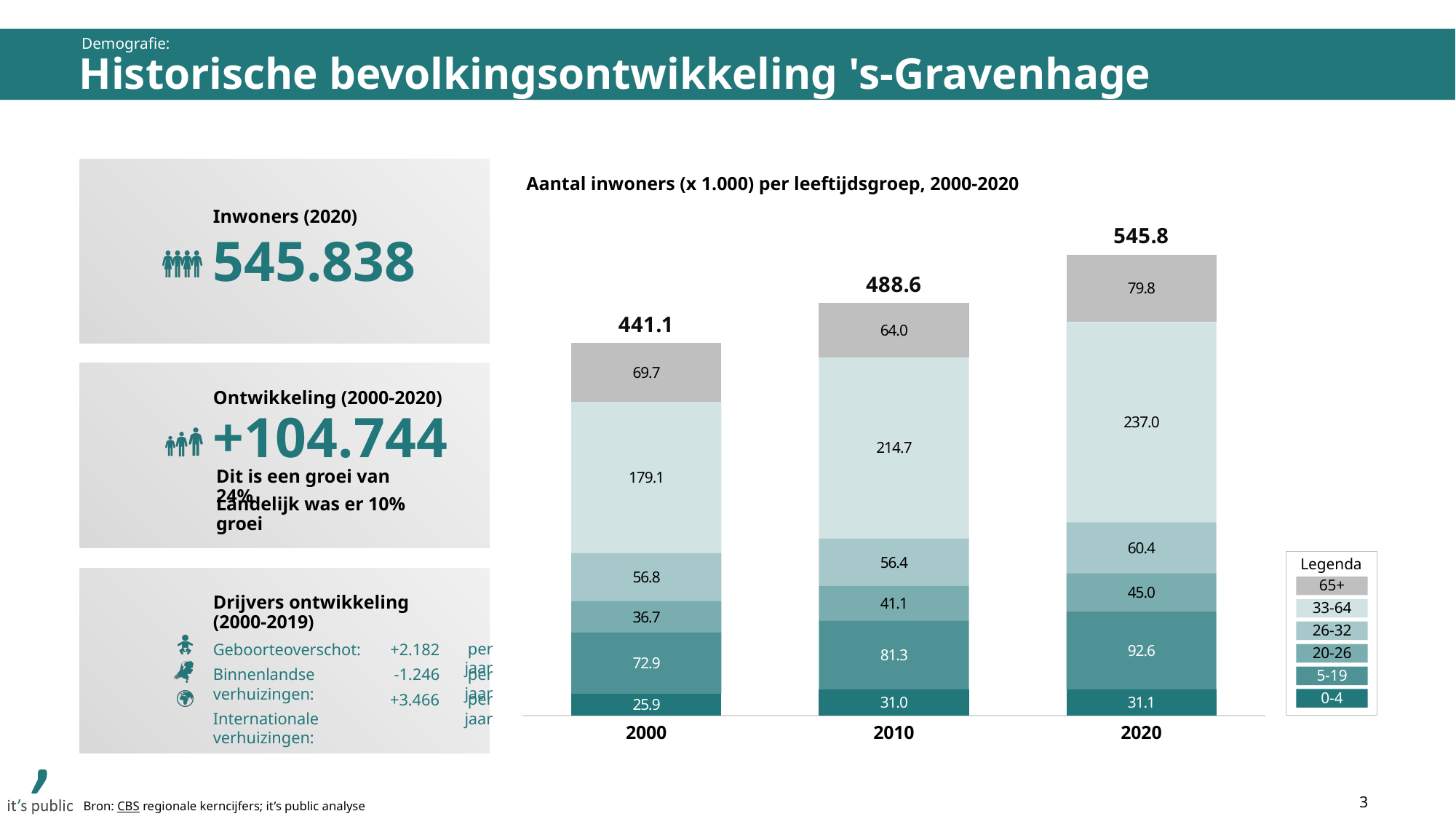
Which is larger: the 65+ value in 2000 or in 2010? 2000 What is the total number of inhabitants (x 1.000) shown for 2020? 545.8 What is the difference between the 33-64 values for 2020 and 2000? 57.9 Which year has the highest total number of inhabitants? 2020 What is the value for the 5-19 age group in 2020? 92.6 Which year has the lowest value for the 0-4 age group? 2000 What is the value for the 65+ age group in 2000? 69.7 How many years (bars) are shown on the x axis? 3 How many age groups does the legend list? 6 Does the total number of inhabitants rise or fall from 2000 to 2020? Rise What type of chart is shown on the slide? Stacked bar chart What is the value for the 33-64 age group in 2010? 214.7